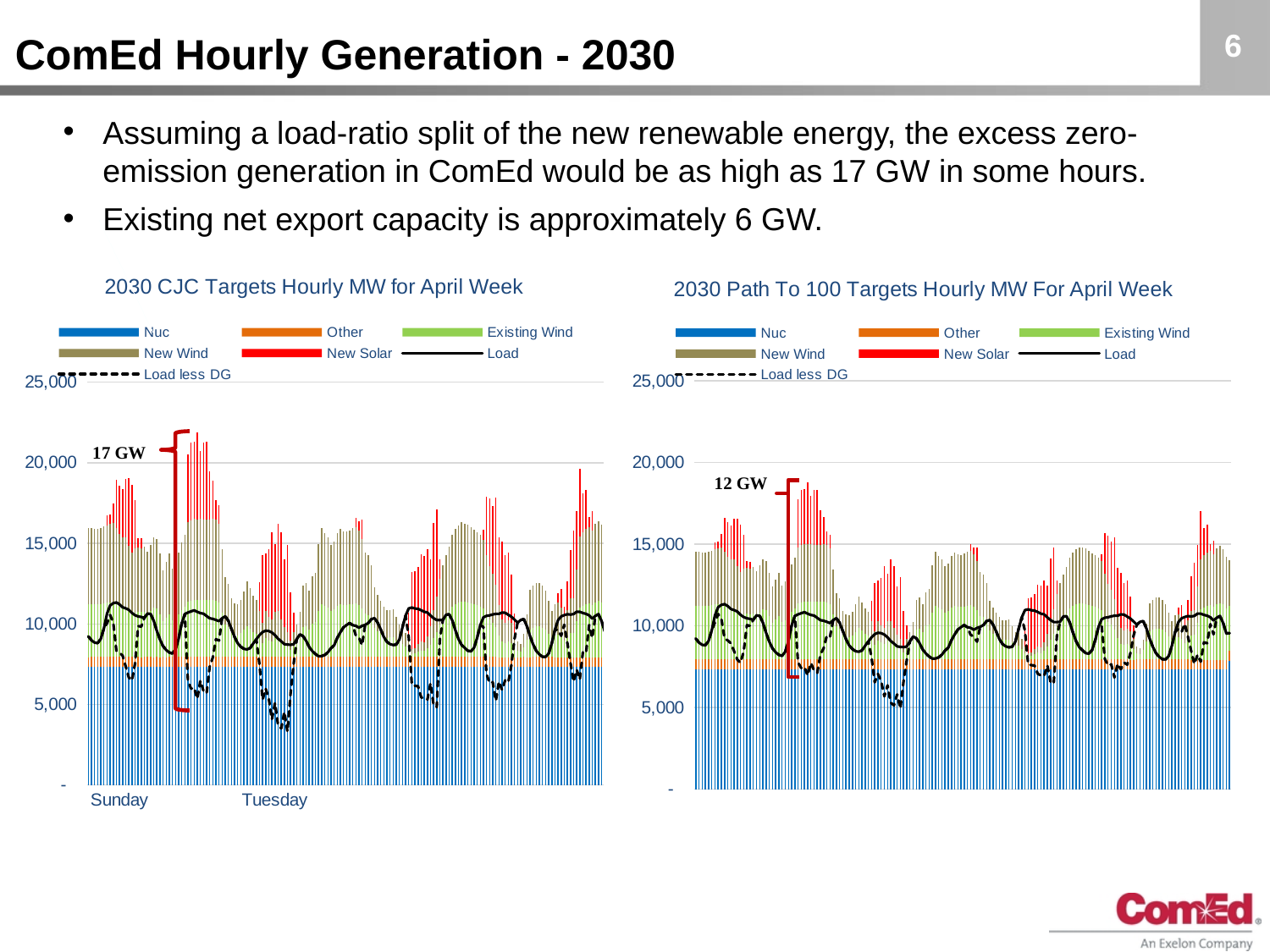
In the '2030 CJC Targets Hourly MW for April Week' chart, is the tallest stacked bar greater or less than 20,000? greater What kind of chart is the '2030 CJC Targets Hourly MW for April Week' chart? Stacked bar chart with line overlays How many series does the legend of the '2030 Path To 100 Targets Hourly MW For April Week' chart list? 7 What is the difference between the annotated excess generation in the CJC Targets chart (17 GW) and in the Path To 100 Targets chart (12 GW)? 5 GW Which two day labels appear on the x axis of the '2030 CJC Targets Hourly MW for April Week' chart? Sunday and Tuesday What is the highest value shown on the y axis of the '2030 Path To 100 Targets Hourly MW For April Week' chart? 25,000 In the '2030 Path To 100 Targets Hourly MW For April Week' chart, is the tallest stacked bar greater or less than 20,000? less In the '2030 CJC Targets Hourly MW for April Week' chart, is the Nuc (blue) portion of the bars greater or less than 5,000? greater Which chart shows the larger annotated excess generation, the CJC Targets chart or the Path To 100 Targets chart? CJC Targets chart In the '2030 Path To 100 Targets Hourly MW For April Week' chart, what excess generation value is annotated? 12 GW In the '2030 CJC Targets Hourly MW for April Week' chart, what excess generation value is annotated? 17 GW